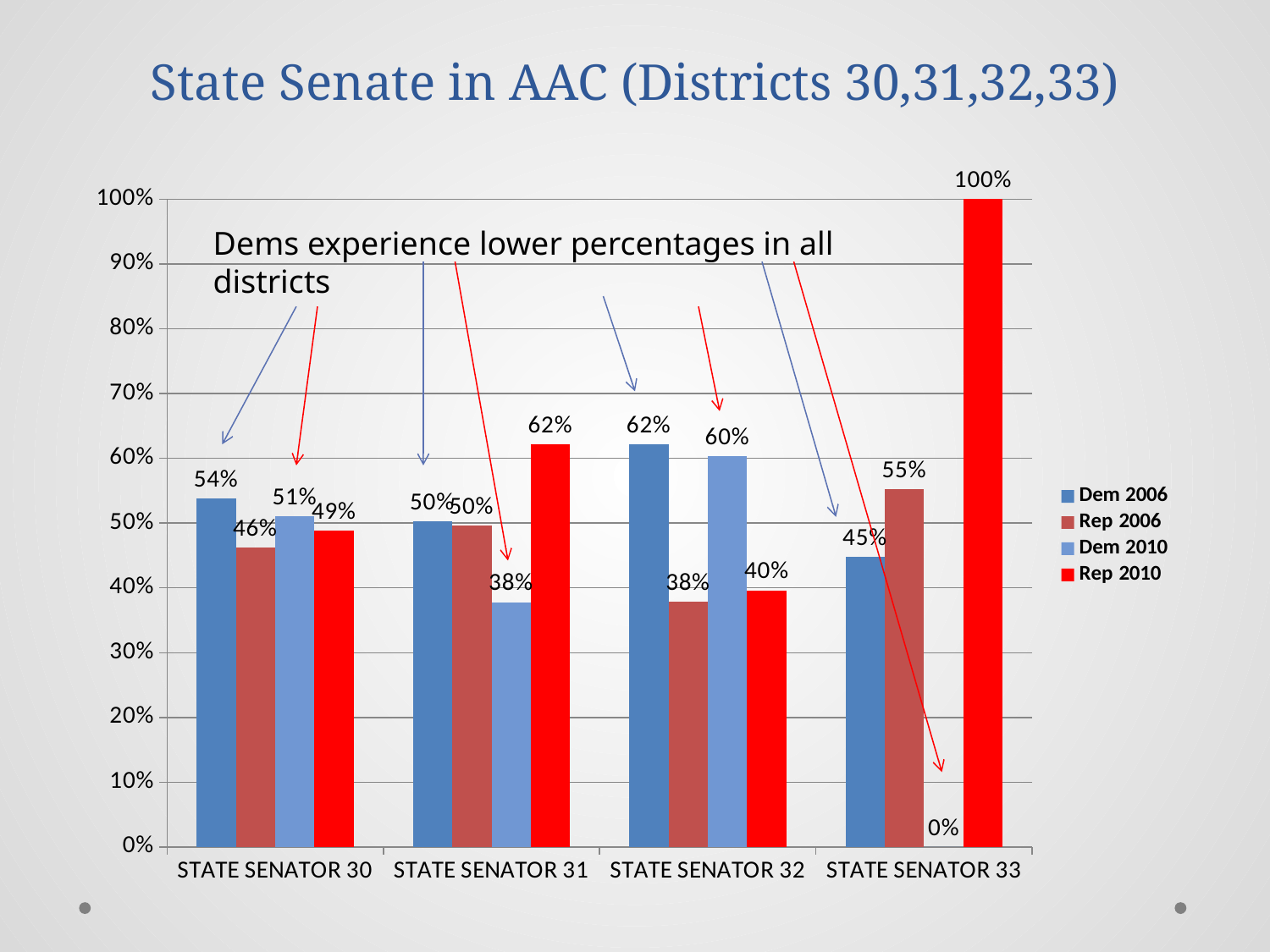
What is the Dem 2006 value for STATE SENATOR 30? 54% What is the Dem 2010 value for STATE SENATOR 31? 38% What kind of chart is shown on the slide? Bar chart What is the difference between the Rep 2010 and Dem 2010 values for STATE SENATOR 31? 24% What is the Rep 2006 value for STATE SENATOR 33? 55% How many districts are shown on the x axis? 4 Which district has the lowest Dem 2010 value? STATE SENATOR 33 Which district has the highest Dem 2006 value? STATE SENATOR 32 Which is larger for STATE SENATOR 32: the Rep 2006 value or the Dem 2010 value? Dem 2010 What is the Rep 2010 value for STATE SENATOR 33? 100% How many series does the legend list? 4 What is the title of the slide? State Senate in AAC (Districts 30,31,32,33)